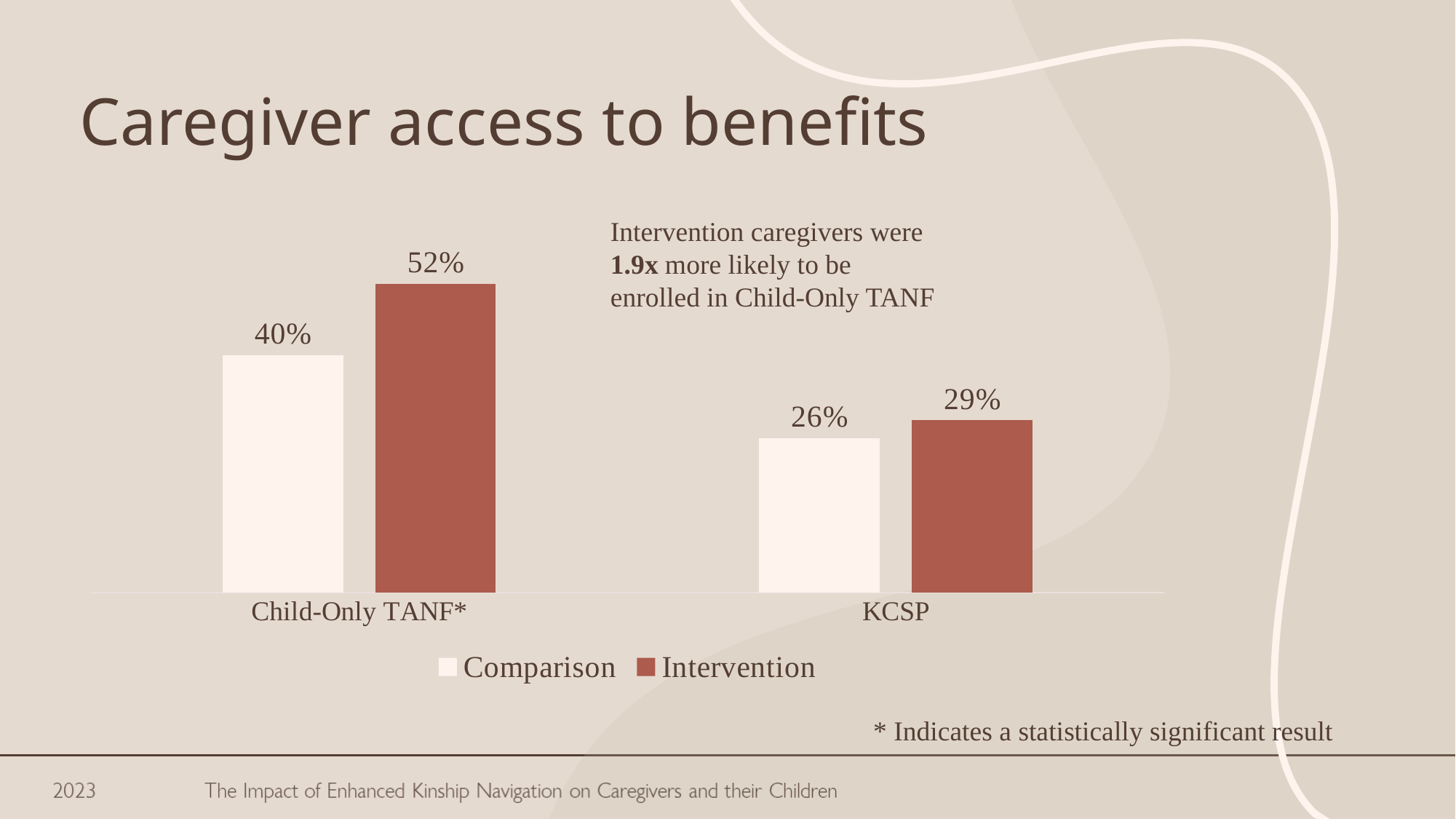
Which is larger for KCSP, the Comparison value or the Intervention value? Intervention How many series does the chart legend list? 2 What kind of chart is shown on the slide? Bar chart Which bar has the lowest value on the chart? Comparison, KCSP What is the Intervention value for KCSP? 29% What is the Intervention value for Child-Only TANF*? 52% What is the Comparison value for KCSP? 26% What is the Comparison value for Child-Only TANF*? 40% How many categories are shown on the x axis of the chart? 2 Which bar has the highest value on the chart? Intervention, Child-Only TANF* What is the difference between the Intervention and Comparison values for KCSP? 3% What is the difference between the Intervention and Comparison values for Child-Only TANF*? 12%